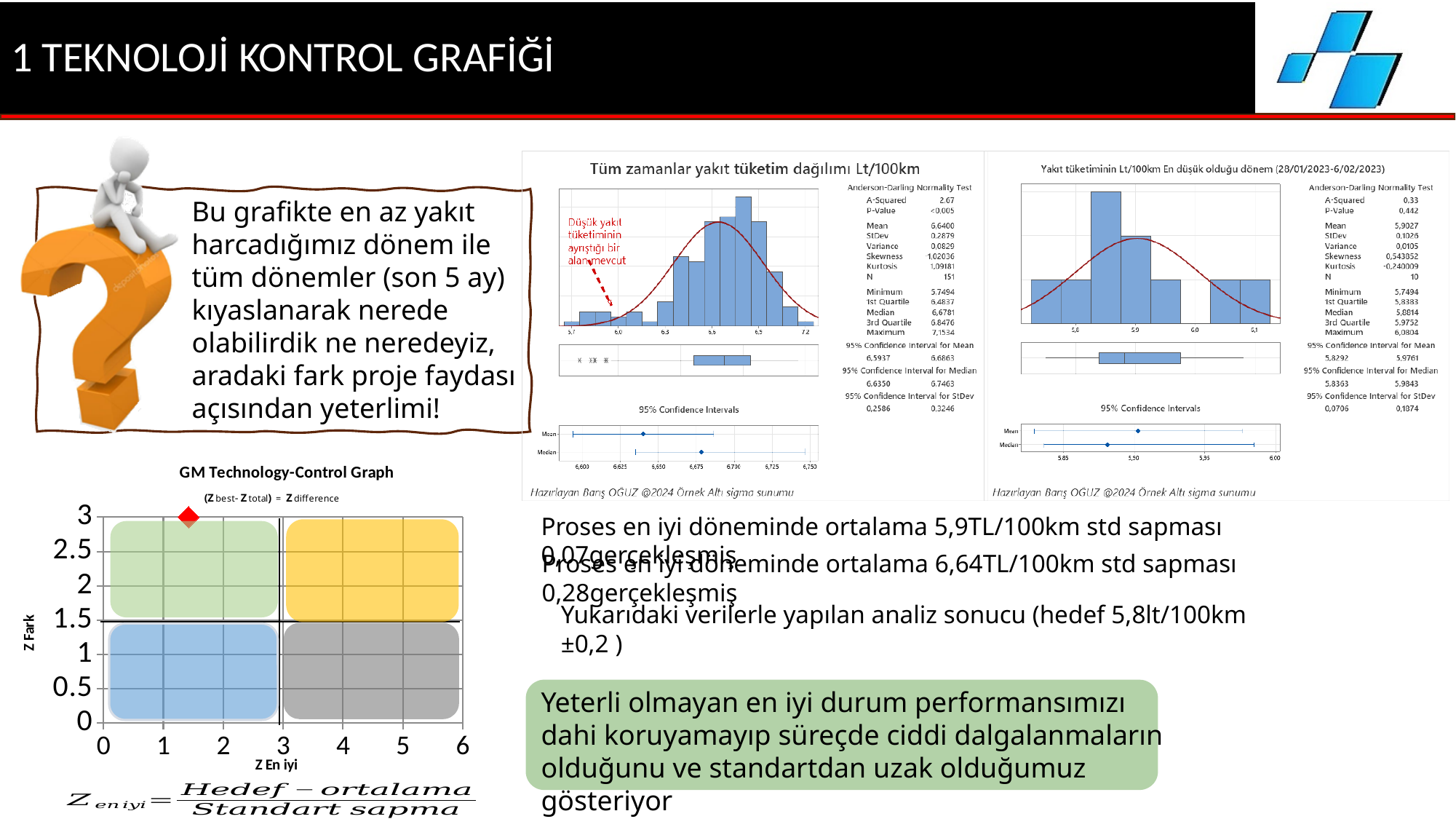
What kind of chart is the GM Technology-Control Graph? scatter chart What is the label of the y axis on the GM Technology-Control Graph? Z Fark In the 'Yakıt tüketiminin Lt/100km En düşük olduğu dönem' panel, what is the Mean value listed? 5,9027 What is the label of the x axis on the GM Technology-Control Graph? Z En iyi What kind of chart is shown in the 'Tüm zamanlar yakıt tüketim dağılımı Lt/100km' panel? histogram On the GM Technology-Control Graph, is the Z Fark value of the plotted point greater or less than 1.5? greater How many data points are plotted on the GM Technology-Control Graph? 1 On the GM Technology-Control Graph, is the Z En iyi value of the plotted point greater or less than 3? less In the 'Tüm zamanlar yakıt tüketim dağılımı Lt/100km' panel, what is the Mean value listed? 6,6400 Which panel lists the larger StDev: 'Tüm zamanlar yakıt tüketim dağılımı Lt/100km' or 'Yakıt tüketiminin Lt/100km En düşük olduğu dönem'? Tüm zamanlar yakıt tüketim dağılımı Lt/100km In the 'Tüm zamanlar yakıt tüketim dağılımı Lt/100km' panel, what is N? 151 In the 'Yakıt tüketiminin Lt/100km En düşük olduğu dönem' panel, what is the StDev value listed? 0,1026